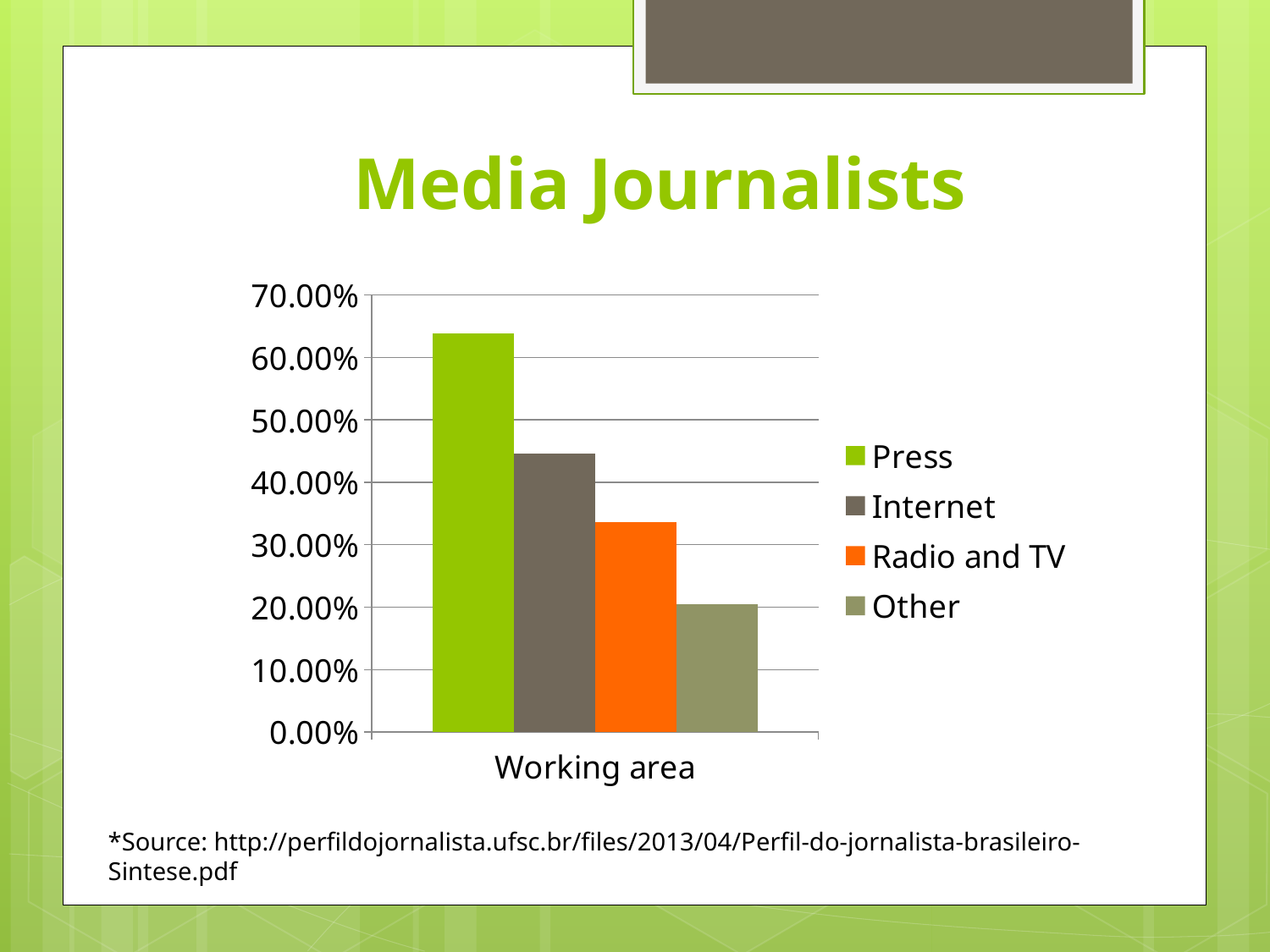
What is the title of the slide containing the chart? Media Journalists Which series has the lowest value? Other Is the value for Internet greater or less than 40.00%? greater Which is larger, the value for Other or the value for Press? Press Is the value for Press greater or less than 60.00%? greater Which is larger, the value for Internet or the value for Radio and TV? Internet Which series has the highest value? Press Is the value for Other greater or less than 30.00%? less What kind of chart is shown on the slide? bar chart What is the label on the x axis of the chart? Working area How many series does the legend list? 4